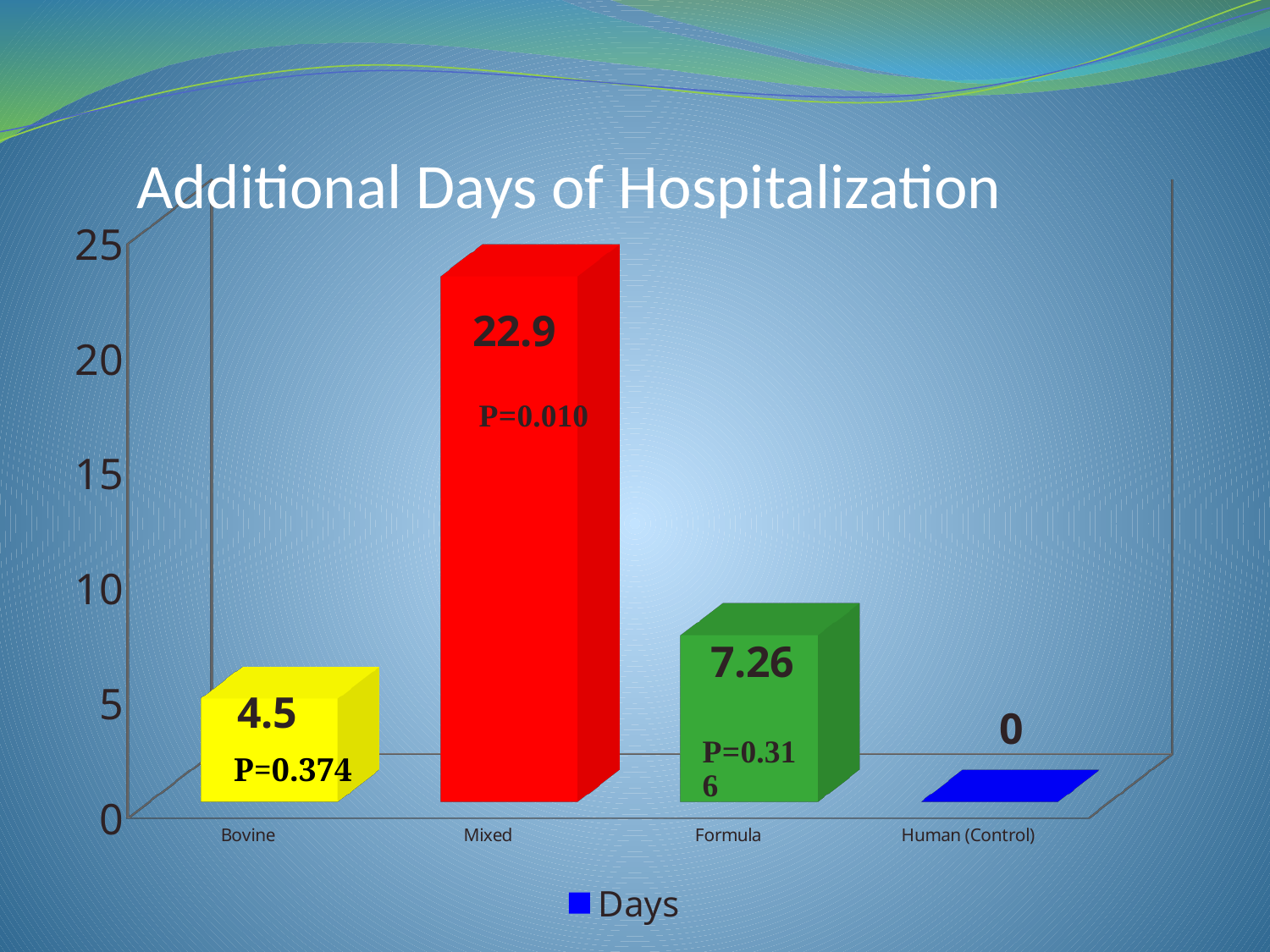
What is the value for Mixed? 22.9 What is the value for Human (Control)? 0 Which category has the lowest value? Human (Control) What is the title of the chart? Additional Days of Hospitalization Which category has the highest value? Mixed What is the difference between the values for Mixed and Formula? 15.64 Is the value for Mixed greater or less than 20? greater Which is larger, the value for Formula or the value for Bovine? Formula How many categories are shown on the x axis? 4 What is the value for Formula? 7.26 What kind of chart is shown? bar chart What is the value for Bovine? 4.5